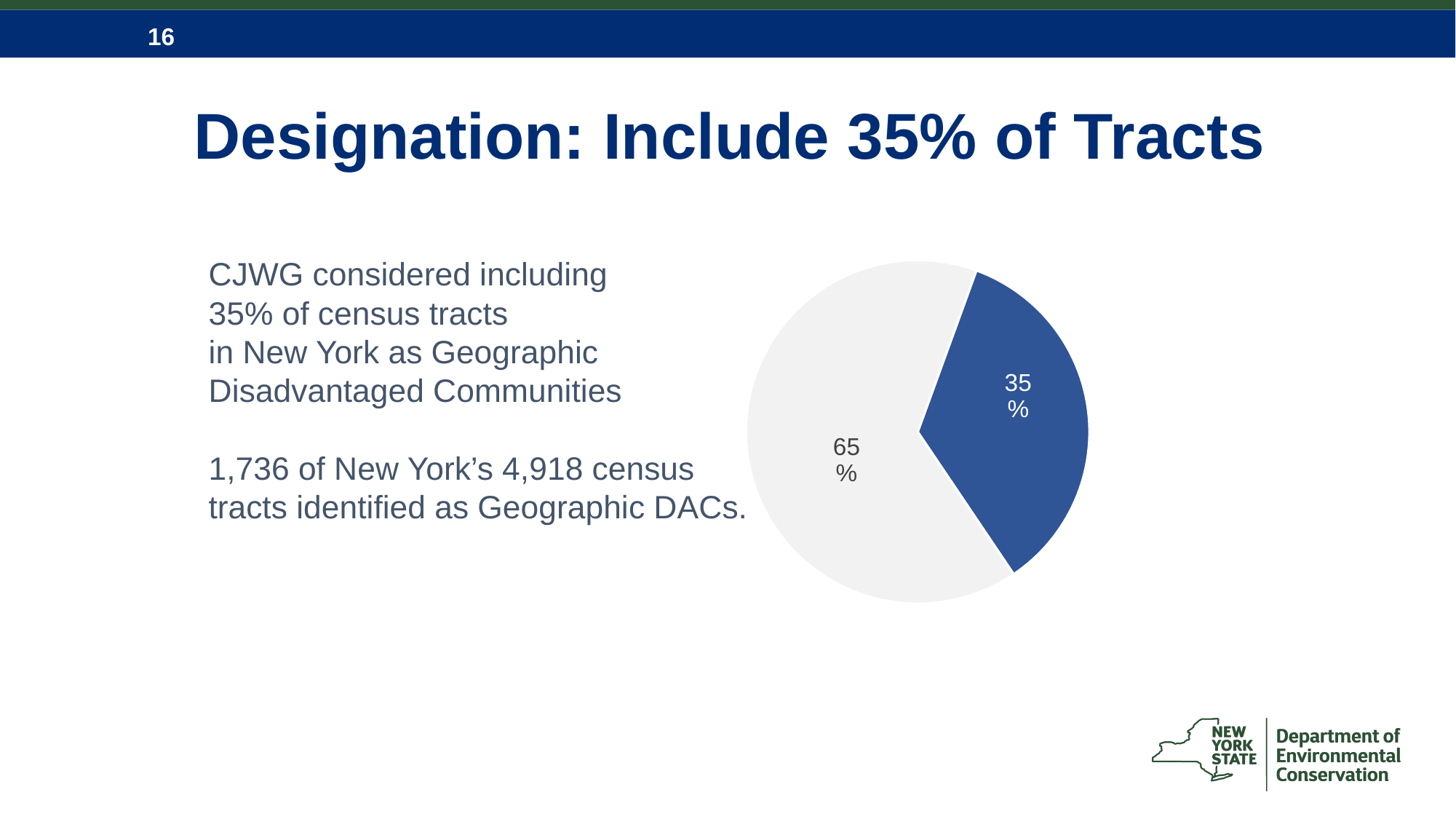
Which slice of the pie chart is the smallest? the blue slice (35%) What percentage is shown on the light gray slice of the pie chart? 65% What is the difference in percentage points between the light gray slice and the blue slice of the pie chart? 30 percentage points Does the pie chart have a legend? No What colour is the slice labelled 35% in the pie chart? blue How many slices does the pie chart have? 2 What do the two slices of the pie chart add up to? 100% Which slice of the pie chart is the largest? the light gray slice (65%) What share of the pie does the blue slice represent? 35% Which is larger in the pie chart, the blue slice or the light gray slice? the light gray slice What kind of chart is shown on the slide? pie chart What percentage is shown on the blue slice of the pie chart? 35%